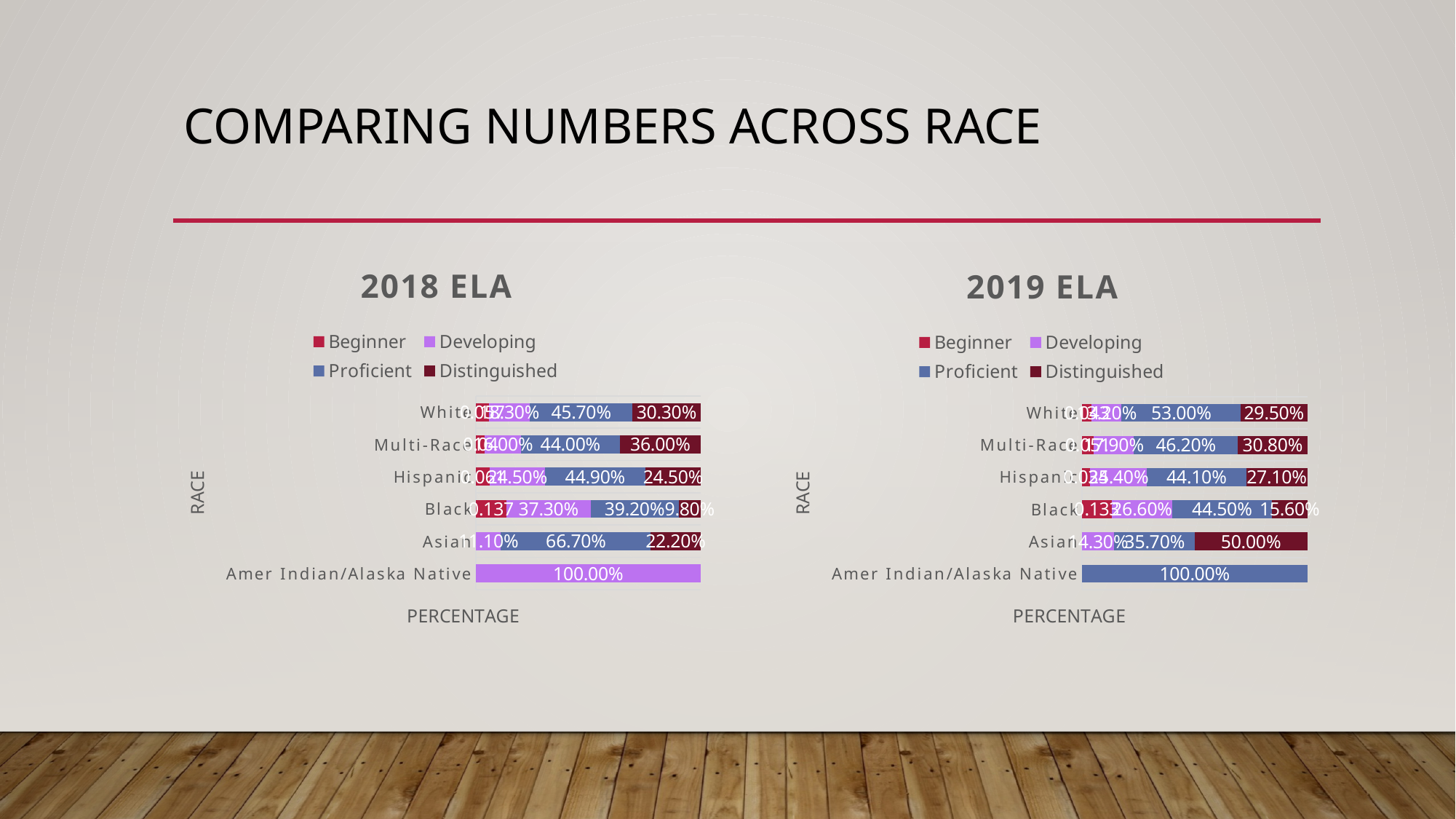
In the 2018 ELA chart, what is the Distinguished value for Multi-Race? 36.00% What is the difference between the Proficient value for White in the 2019 ELA chart and in the 2018 ELA chart? 7.30% What kind of chart is the 2018 ELA chart? Stacked bar chart Is the Proficient value for Black larger in the 2018 ELA chart or the 2019 ELA chart? 2019 ELA In the 2019 ELA chart, what is the Proficient value for White? 53.00% In the 2019 ELA chart, what is the Distinguished value for Asian? 50.00% How many race categories are shown in the 2018 ELA chart? 6 In the 2018 ELA chart, which race has the lowest Distinguished value among those with a Distinguished label? Black In the 2019 ELA chart, which race has the highest Distinguished value? Asian How many series does the legend of the 2019 ELA chart list? 4 In the 2018 ELA chart, what is the Developing value for Black? 37.30% In the 2018 ELA chart, what is the Proficient value for Asian? 66.70%